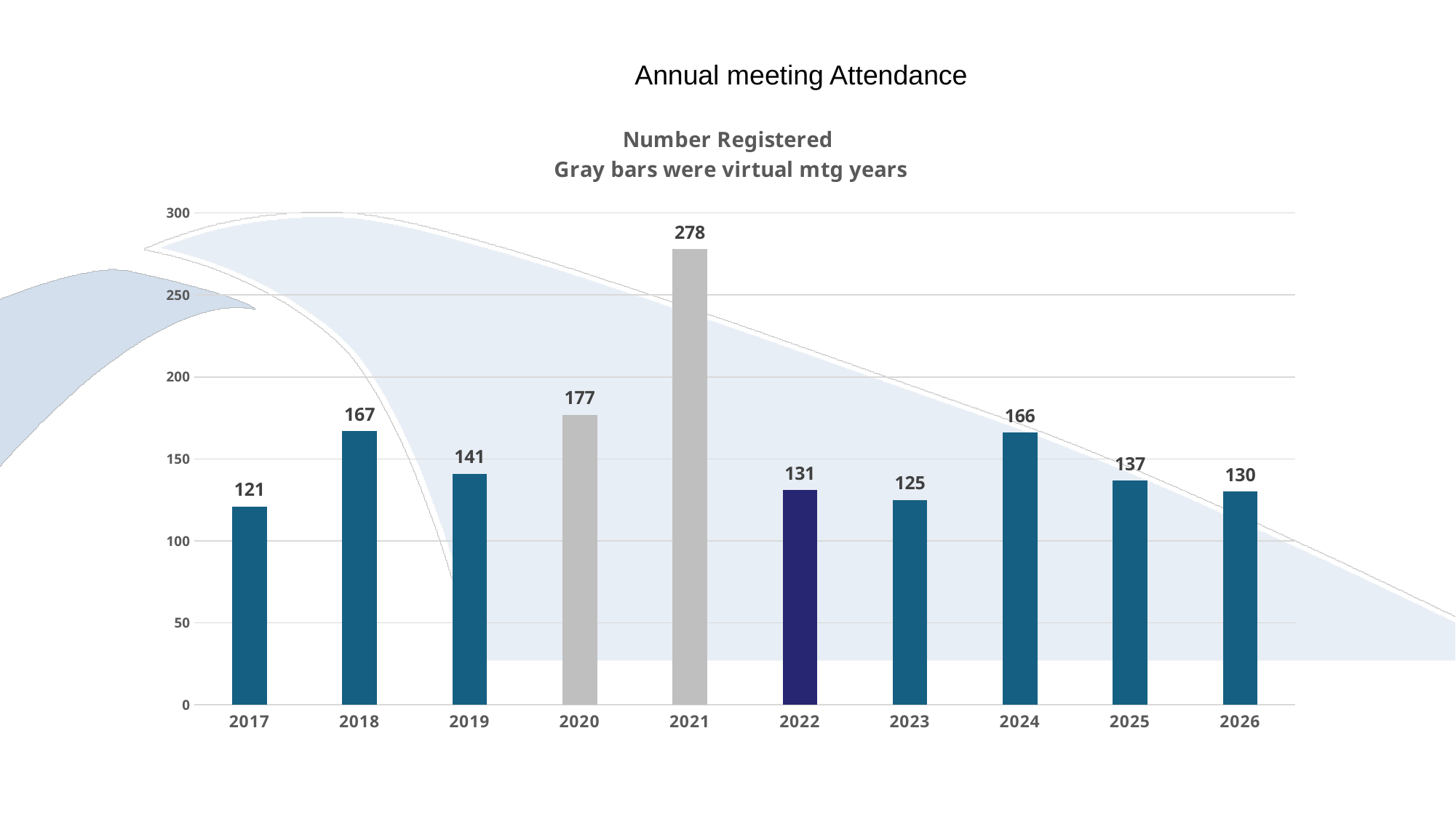
What is the number registered for 2021? 278 According to the chart subtitle, what do the gray bars represent? Virtual meeting years What is the difference between the number registered in 2021 and in 2020? 101 What kind of chart is shown on the slide? Bar chart Which year had more registered, 2022 or 2023? 2022 Which year has the lowest number registered? 2017 What is the number registered for 2017? 121 Is the value for 2020 greater or less than 150? greater What is the difference between the number registered in 2018 and in 2019? 26 What is the number registered for 2024? 166 Which year has the highest number registered? 2021 How many years are shown on the x axis? 10